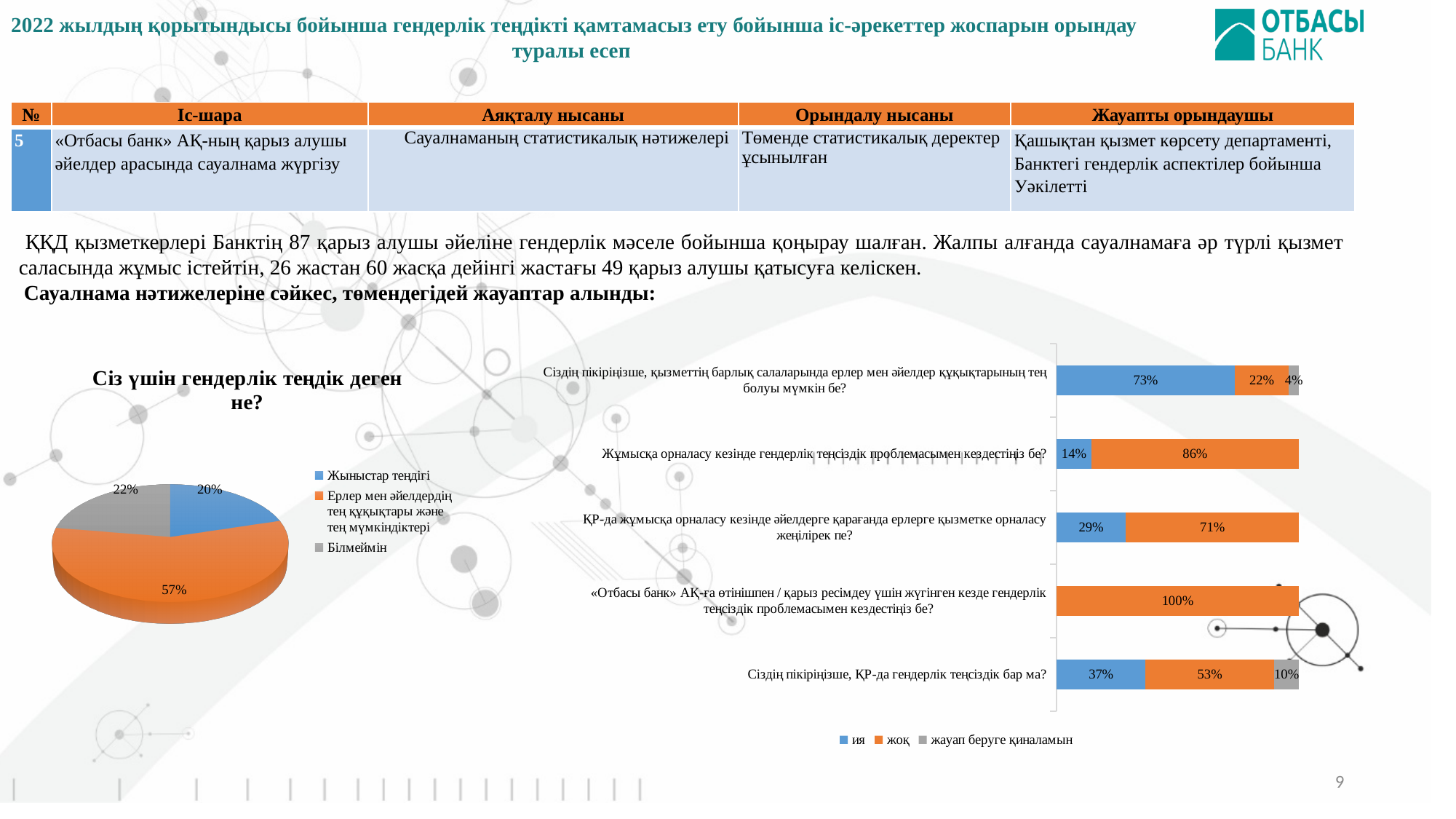
In the pie chart titled "Сіз үшін гендерлік теңдік деген не?", which category has the largest slice? Ерлер мен әйелдердің тең құқықтары және тең мүмкіндіктері In the stacked bar chart on the right, how many questions (categories) are plotted? 5 In the stacked bar chart on the right, what is the "ия" value for "Сіздің пікіріңізше, ҚР-да гендерлік теңсіздік бар ма?"? 37% In the pie chart titled "Сіз үшін гендерлік теңдік деген не?", what share is labelled for "Білмеймін"? 22% In the stacked bar chart on the right, which question has a "жоқ" value of 100%? «Отбасы банк» АҚ-ға өтінішпен / қарыз ресімдеу үшін жүгінген кезде гендерлік теңсіздік проблемасымен кездестіңіз бе? In the stacked bar chart on the right, how many series does the legend list? 3 In the stacked bar chart on the right, what is the "жоқ" value for "Жұмысқа орналасу кезінде гендерлік теңсіздік проблемасымен кездестіңіз бе?"? 86% In the stacked bar chart on the right, what is the difference between the "жоқ" and "ия" values for "ҚР-да жұмысқа орналасу кезінде әйелдерге қарағанда ерлерге қызметке орналасу жеңілірек пе?"? 42% In the pie chart titled "Сіз үшін гендерлік теңдік деген не?", how many slices are there? 3 In the pie chart titled "Сіз үшін гендерлік теңдік деген не?", which category has the smallest slice? Жыныстар теңдігі In the stacked bar chart on the right, which colour represents the "жоқ" series? Orange What type of chart is the chart on the left titled "Сіз үшін гендерлік теңдік деген не?"? Pie chart